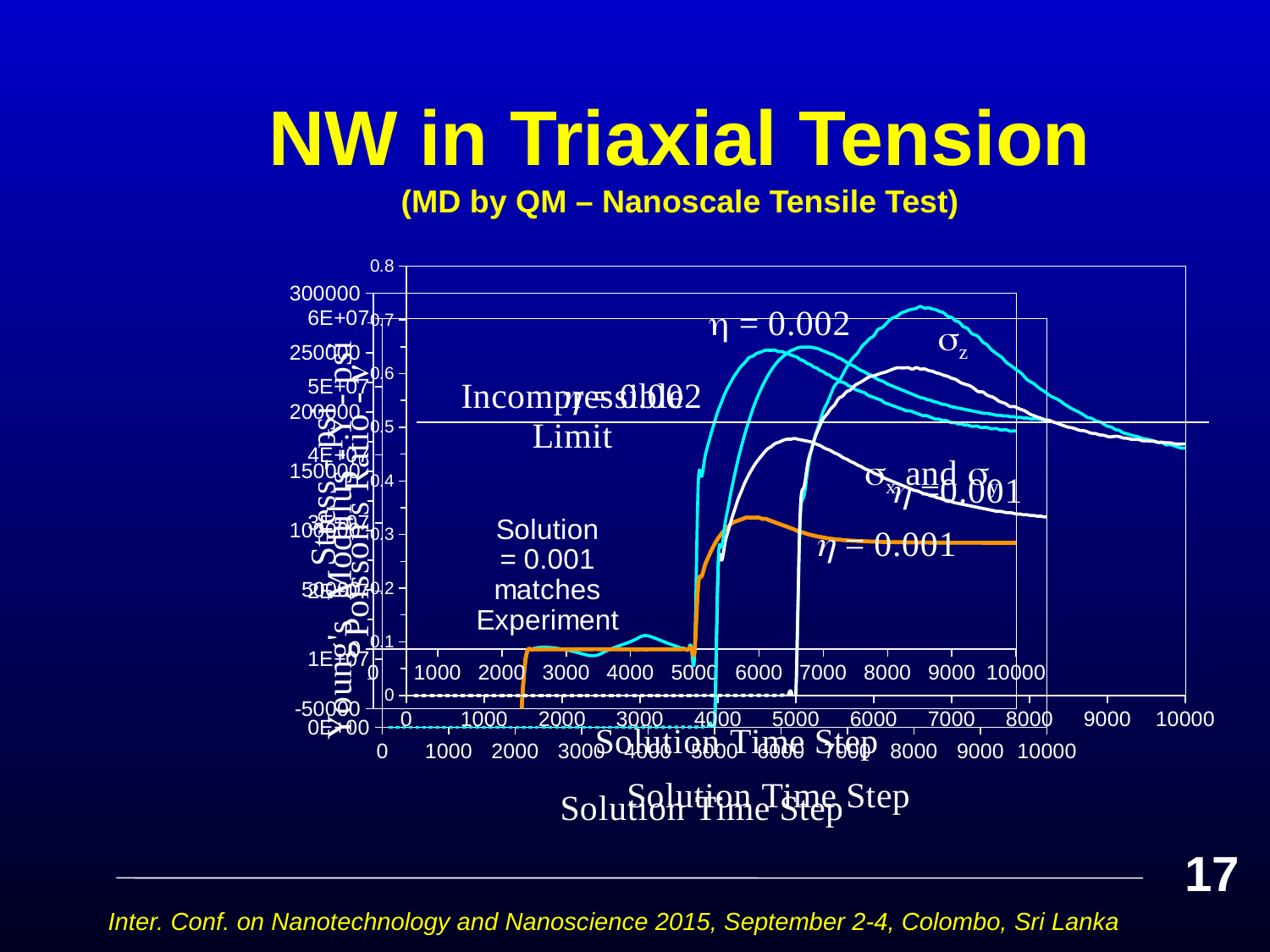
Which value of η does the annotation say matches experiment? 0.001 What is the label on the x axis of the charts? Solution Time Step What kind of chart is shown on the slide? line chart What is the highest value shown on the Poisson's ratio axis (the axis running from 0 to 0.8)? 0.8 At what Poisson's ratio value is the horizontal line labelled "Incompressible Limit" drawn? 0.5